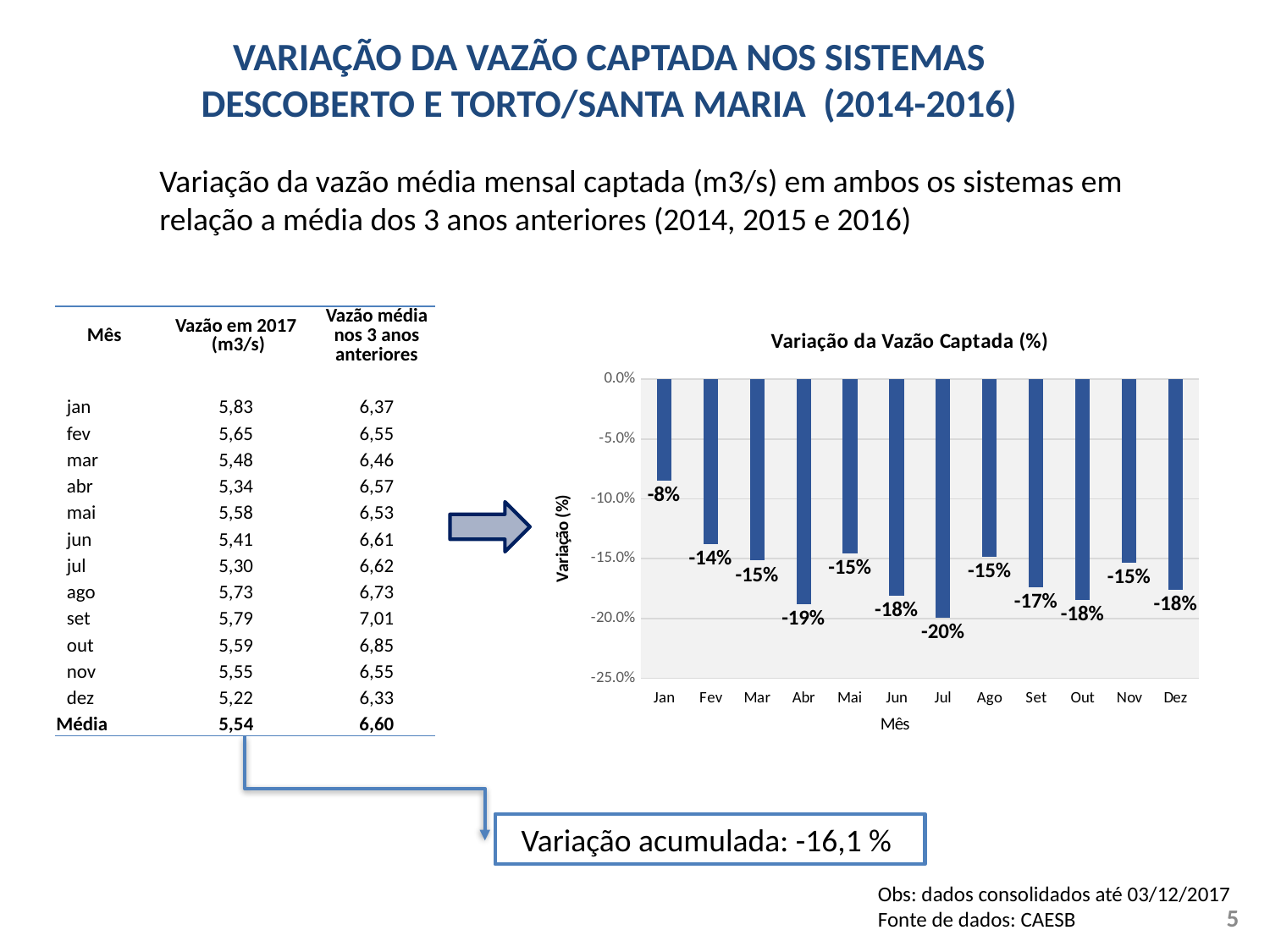
What is the value for Set in the chart 'Variação da Vazão Captada (%)'? -17% In the chart 'Variação da Vazão Captada (%)', what is the difference in percentage points between the values for Jan and Jul? 12 percentage points What is the value for Jan in the chart 'Variação da Vazão Captada (%)'? -8% In the chart 'Variação da Vazão Captada (%)', which has the larger (less negative) value, Fev or Abr? Fev In the chart 'Variação da Vazão Captada (%)', is the value for Jan greater or less than -10.0%? greater In the chart 'Variação da Vazão Captada (%)', is the value for Jul greater or less than -15.0%? less Which month has the lowest (most negative) value in the chart 'Variação da Vazão Captada (%)'? Jul How many months are plotted in the chart 'Variação da Vazão Captada (%)'? 12 What type of chart is 'Variação da Vazão Captada (%)'? Bar chart Which month has the highest (least negative) value in the chart 'Variação da Vazão Captada (%)'? Jan What is the label of the vertical axis in the chart 'Variação da Vazão Captada (%)'? Variação (%) What is the value for Jul in the chart 'Variação da Vazão Captada (%)'? -20%